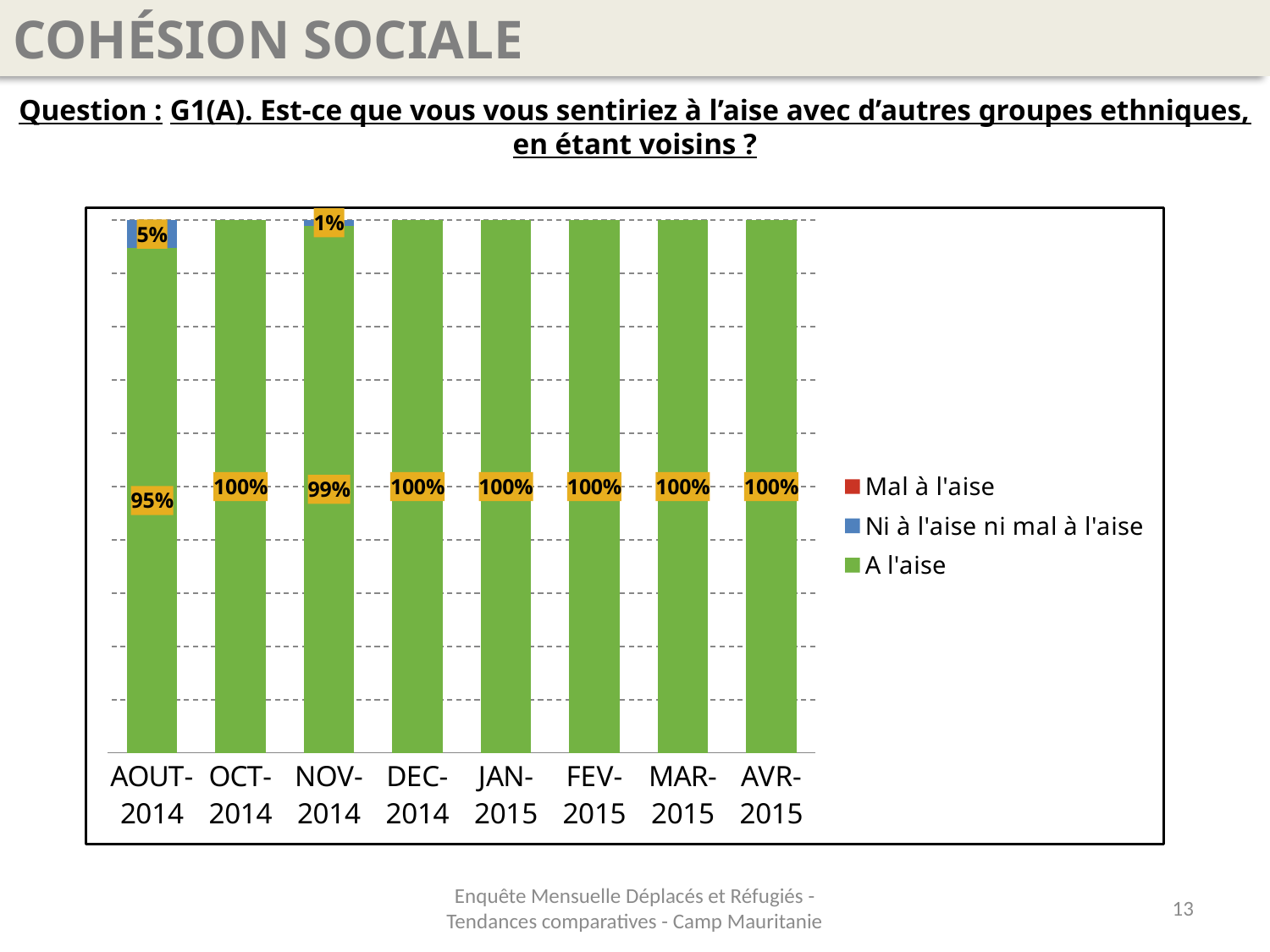
How many months are shown on the x axis? 8 What is the value for 'A l'aise' in NOV-2014? 99% How many series does the legend list? 3 Which is larger, the 'A l'aise' value for AOUT-2014 or for NOV-2014? NOV-2014 Which month has the lowest value for 'A l'aise'? AOUT-2014 What is the value for 'A l'aise' in AOUT-2014? 95% What is the value for 'A l'aise' in AVR-2015? 100% Which legend entry is shown in green? A l'aise What kind of chart is shown on the slide? Stacked bar chart What is the difference between the 'A l'aise' values for OCT-2014 and AOUT-2014? 5% What is the value for 'Ni à l'aise ni mal à l'aise' in AOUT-2014? 5% What is the value for 'Ni à l'aise ni mal à l'aise' in NOV-2014? 1%